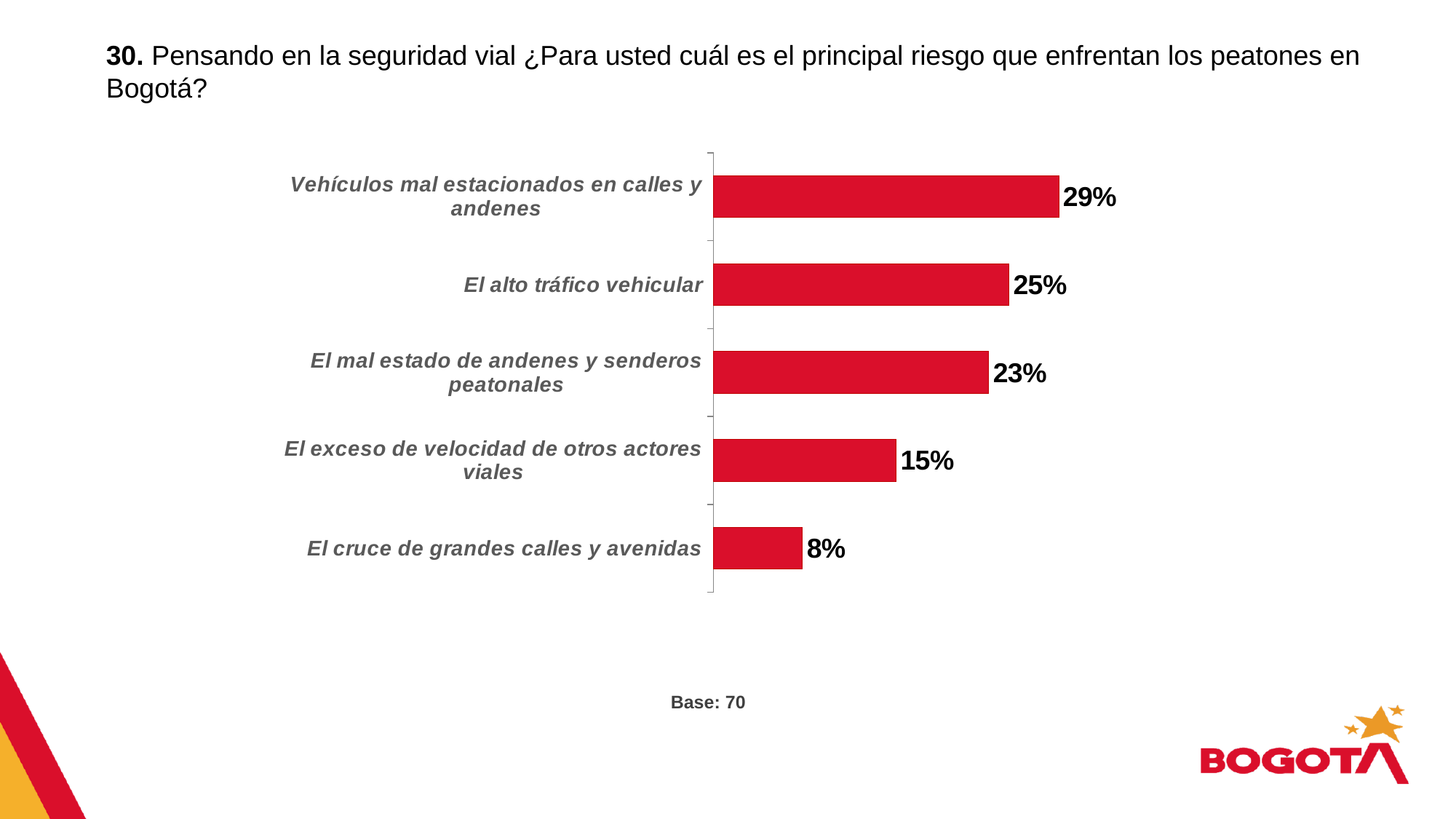
Which category has the lowest percentage? El cruce de grandes calles y avenidas What percentage is shown for "El exceso de velocidad de otros actores viales"? 15% How many categories are shown in the chart? 5 What percentage is shown for "Vehículos mal estacionados en calles y andenes"? 29% What percentage is shown for "El mal estado de andenes y senderos peatonales"? 23% What type of chart is shown on the slide? Bar chart Which category has the highest percentage? Vehículos mal estacionados en calles y andenes What is the base (number of respondents) stated below the chart? 70 Which is larger: the value for "El alto tráfico vehicular" or the value for "El exceso de velocidad de otros actores viales"? El alto tráfico vehicular What percentage is shown for "El cruce de grandes calles y avenidas"? 8% What is the difference in percentage points between "Vehículos mal estacionados en calles y andenes" and "El cruce de grandes calles y avenidas"? 21 percentage points What percentage is shown for "El alto tráfico vehicular"? 25%